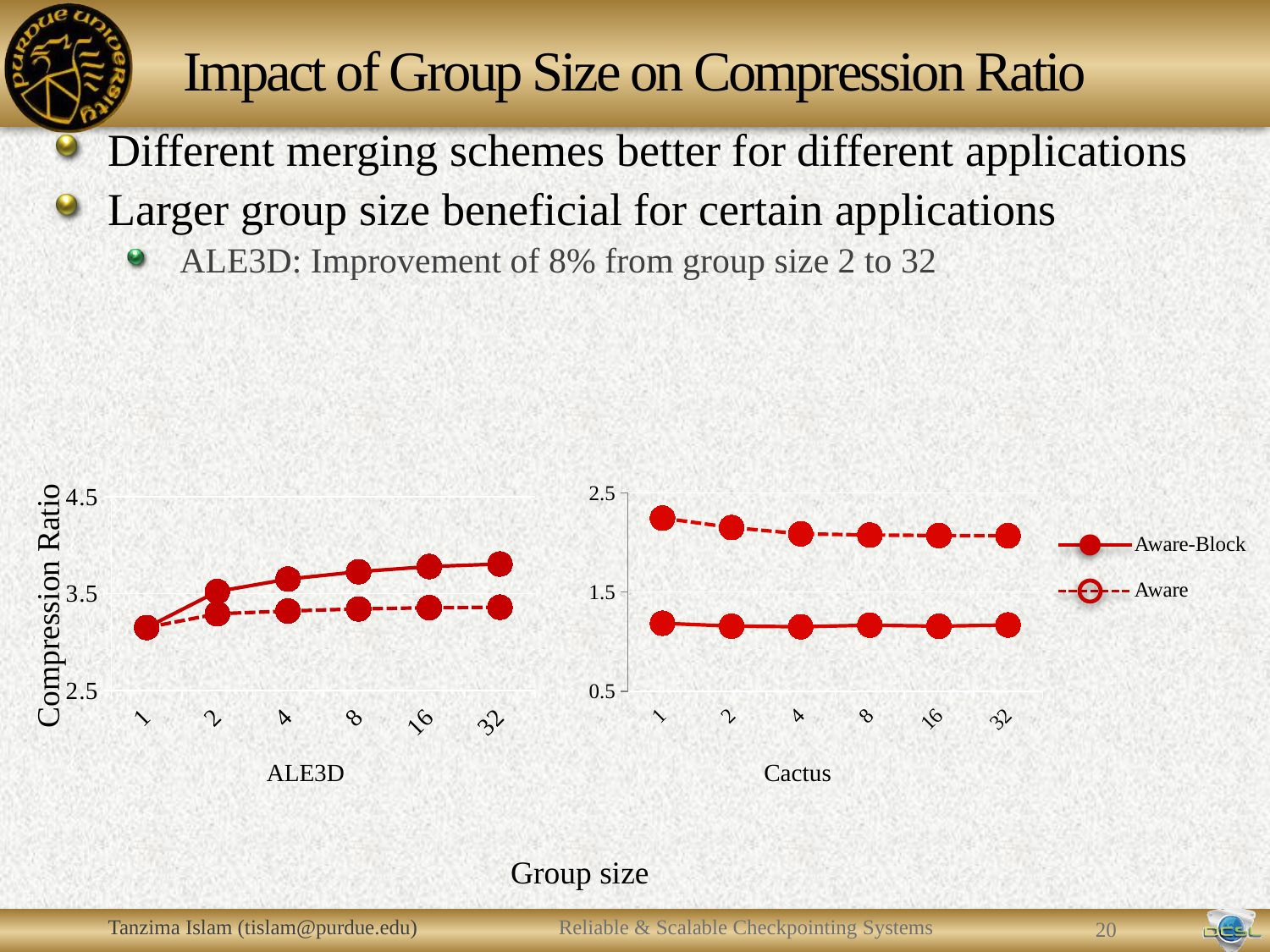
In the Cactus chart, which series is larger at group size 32, Aware-Block or Aware? Aware In the Cactus chart, is the Aware value at group size 1 greater or less than 1.5? greater What kind of chart is the ALE3D chart? line chart In the ALE3D chart, is the Aware value at group size 32 greater or less than 3.5? less In the ALE3D chart, is the Aware-Block value at group size 32 greater or less than 3.5? greater How many series does the legend list? 2 In the ALE3D chart, does the Aware-Block series rise or fall as group size increases? rise In the ALE3D chart, at which group size is the Aware-Block series highest? 32 In the Cactus chart, does the Aware series rise or fall as group size increases? fall How many group sizes are plotted on the x axis of the Cactus chart? 6 Which series is drawn with a dashed line in the legend? Aware